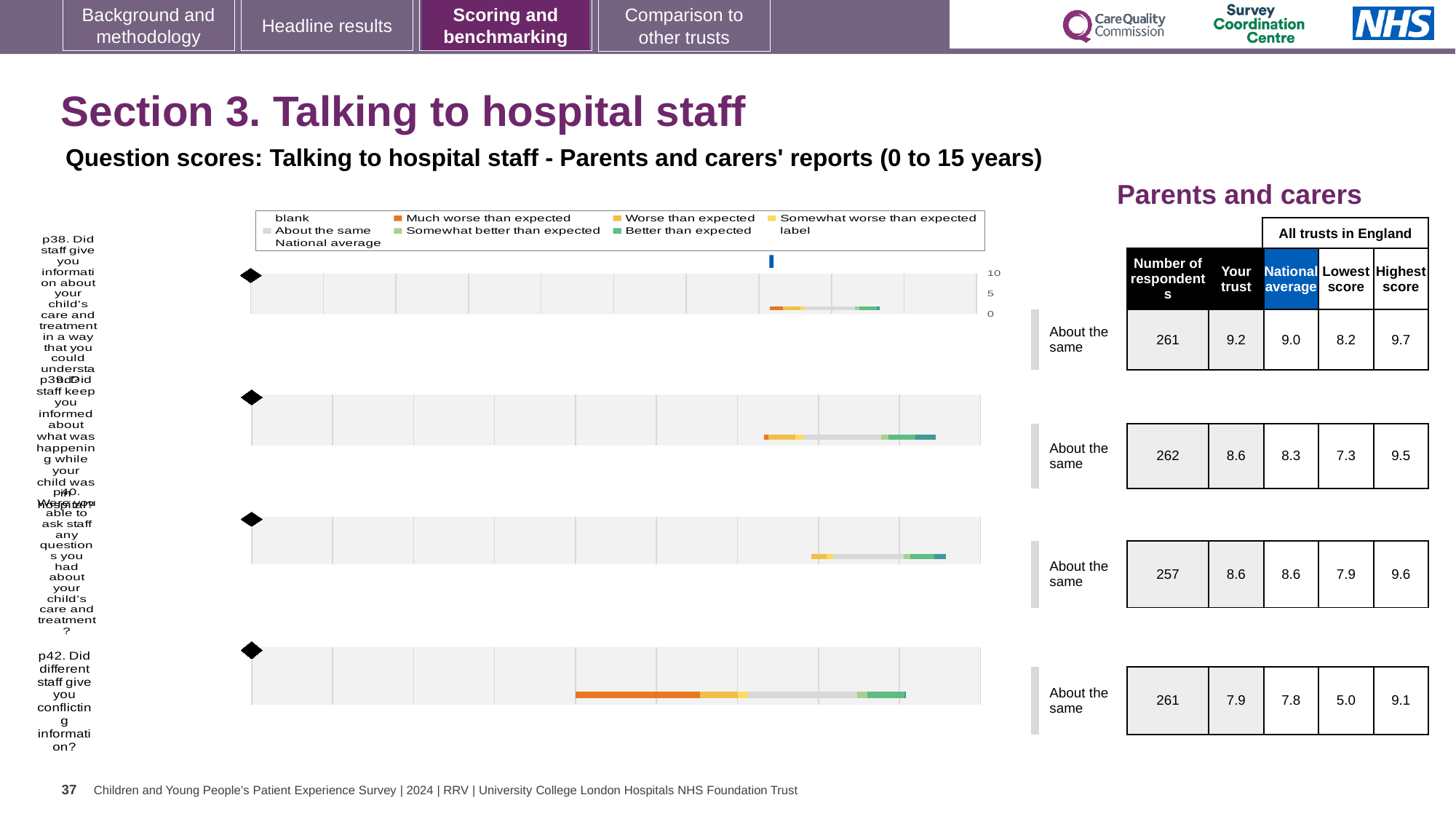
Which question has the lowest 'Your trust' score? p42 What benchmark category label is shown next to each of the four questions? About the same What is the Highest score across all trusts in England for p42? 9.1 For p38, what is the difference between the Highest score and the Lowest score across all trusts in England? 1.5 How many respondents are listed for p40 (Were you able to ask staff any questions you had about your child's care and treatment)? 257 For p39, which is larger: the 'Your trust' score or the National average? Your trust How many survey questions (bars) are shown on the slide? 4 Which question has the highest 'Your trust' score? p38 What is the National average score for p39 (Did staff keep you informed about what was happening while your child was in hospital)? 8.3 What kind of chart is used to show the question scores on this slide? bar chart What is the Lowest score across all trusts in England for p42 (Did different staff give you conflicting information)? 5.0 What is the 'Your trust' score for p38 (Did staff give you information about your child's care and treatment in a way that you could understand)? 9.2